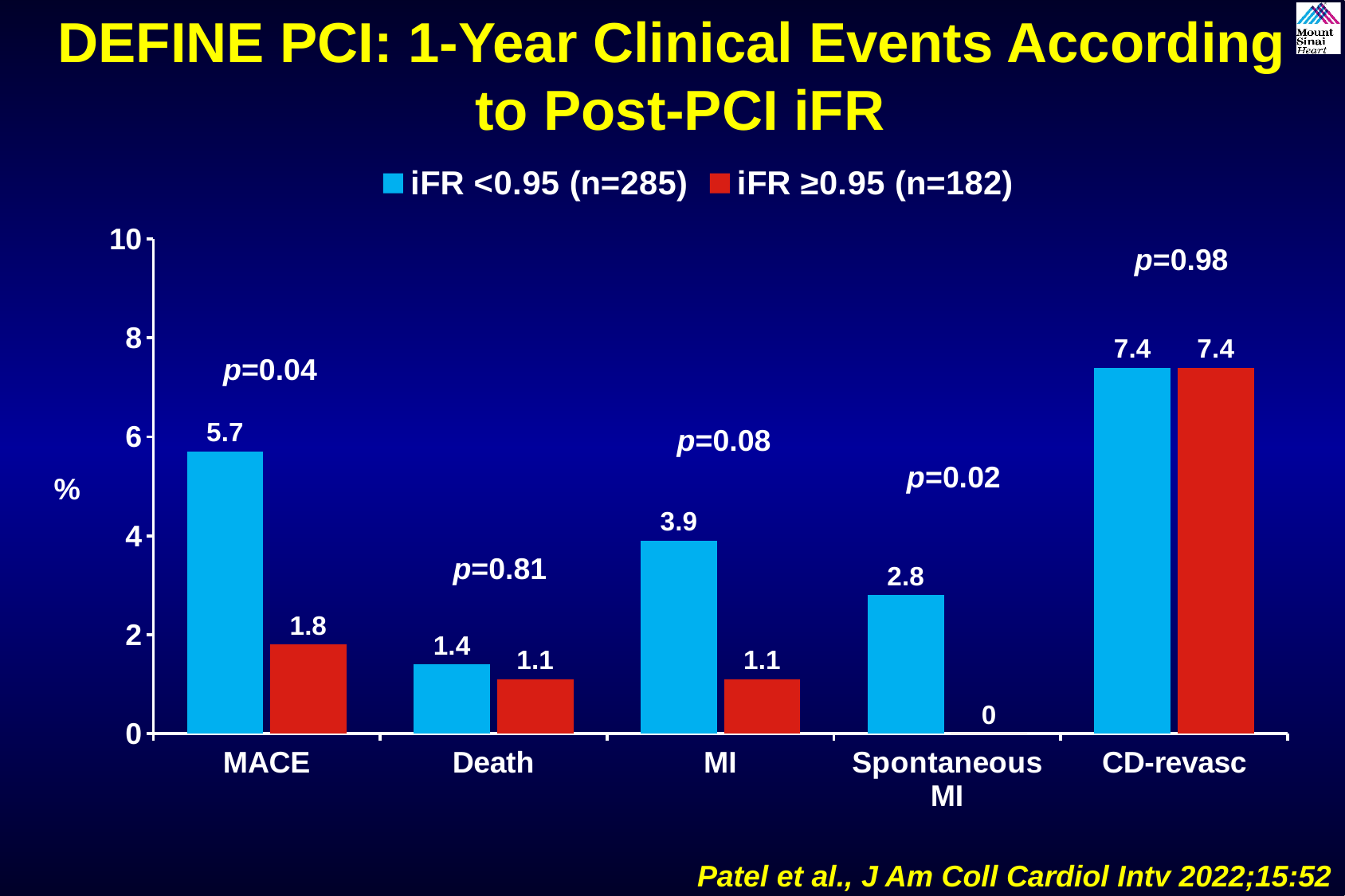
Which category has the lowest value for the iFR ≥0.95 (n=182) group? Spontaneous MI What kind of chart is shown on the slide? Bar chart How many series does the legend list? 2 Which colour represents the iFR ≥0.95 (n=182) group? Red What is the difference between the MACE rates of the iFR <0.95 and iFR ≥0.95 groups? 3.9 What is the CD-revasc rate for the iFR ≥0.95 (n=182) group? 7.4 What is the MACE rate for the iFR <0.95 (n=285) group? 5.7 Which category has the highest value for the iFR <0.95 (n=285) group? CD-revasc How many event categories are shown on the x axis? 5 Which group has the higher MI rate, iFR <0.95 or iFR ≥0.95? iFR <0.95 What p-value is shown above the MACE bars? p=0.04 What is the Spontaneous MI rate for the iFR ≥0.95 (n=182) group? 0